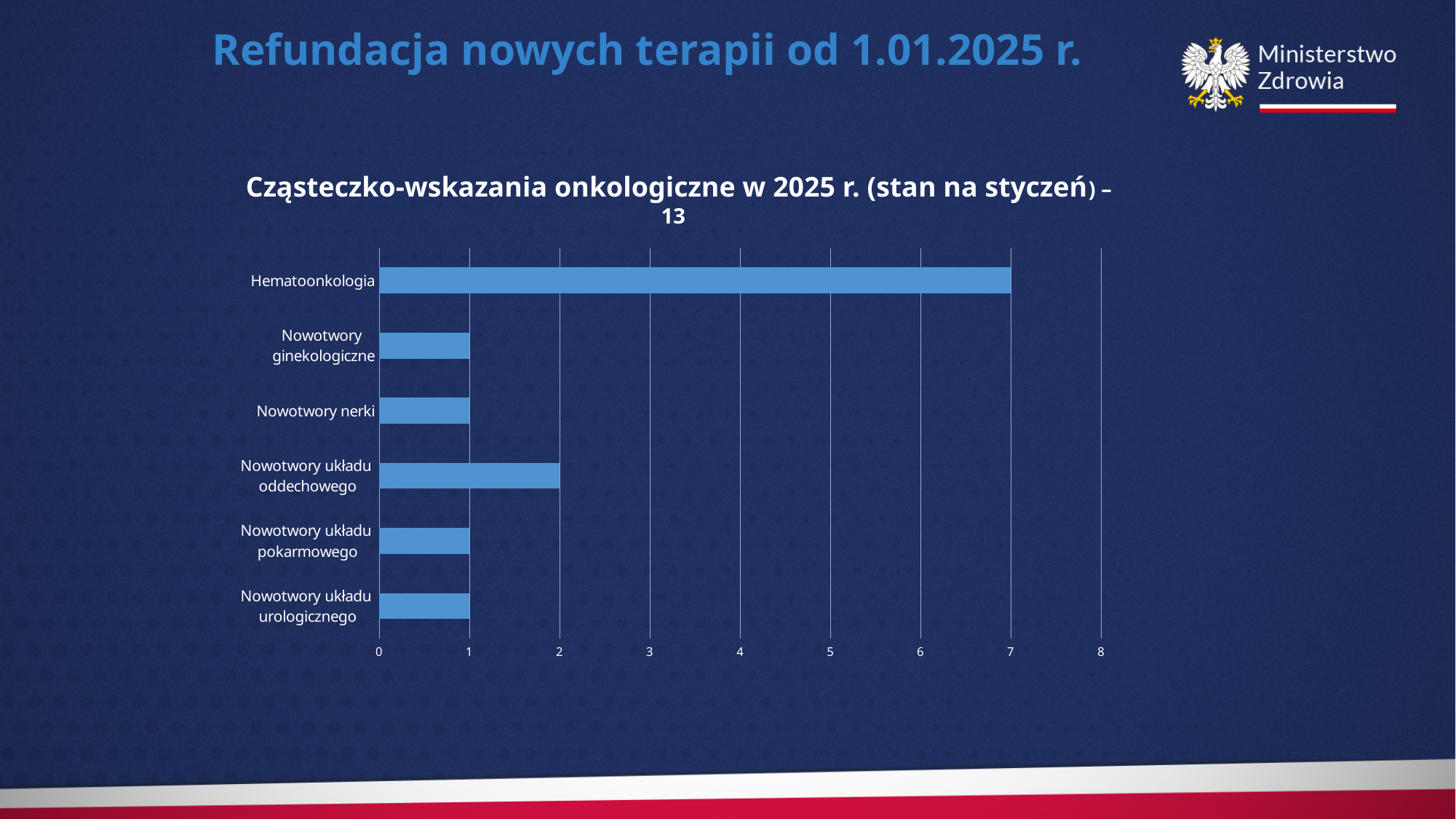
Which is larger, the value for Nowotwory układu oddechowego or the value for Nowotwory ginekologiczne? Nowotwory układu oddechowego What is the value for Nowotwory układu urologicznego? 1 Which category has the highest value? Hematoonkologia What kind of chart is shown on the slide? bar chart What is the value for Hematoonkologia? 7 What is the value for Nowotwory nerki? 1 Is the value for Hematoonkologia greater or less than 6? greater What is the title of the chart? Cząsteczko-wskazania onkologiczne w 2025 r. (stan na styczeń) – 13 How many categories are shown on the chart? 6 What is the highest value shown on the x axis? 8 What is the value for Nowotwory układu oddechowego? 2 What is the difference between the values for Hematoonkologia and Nowotwory układu oddechowego? 5